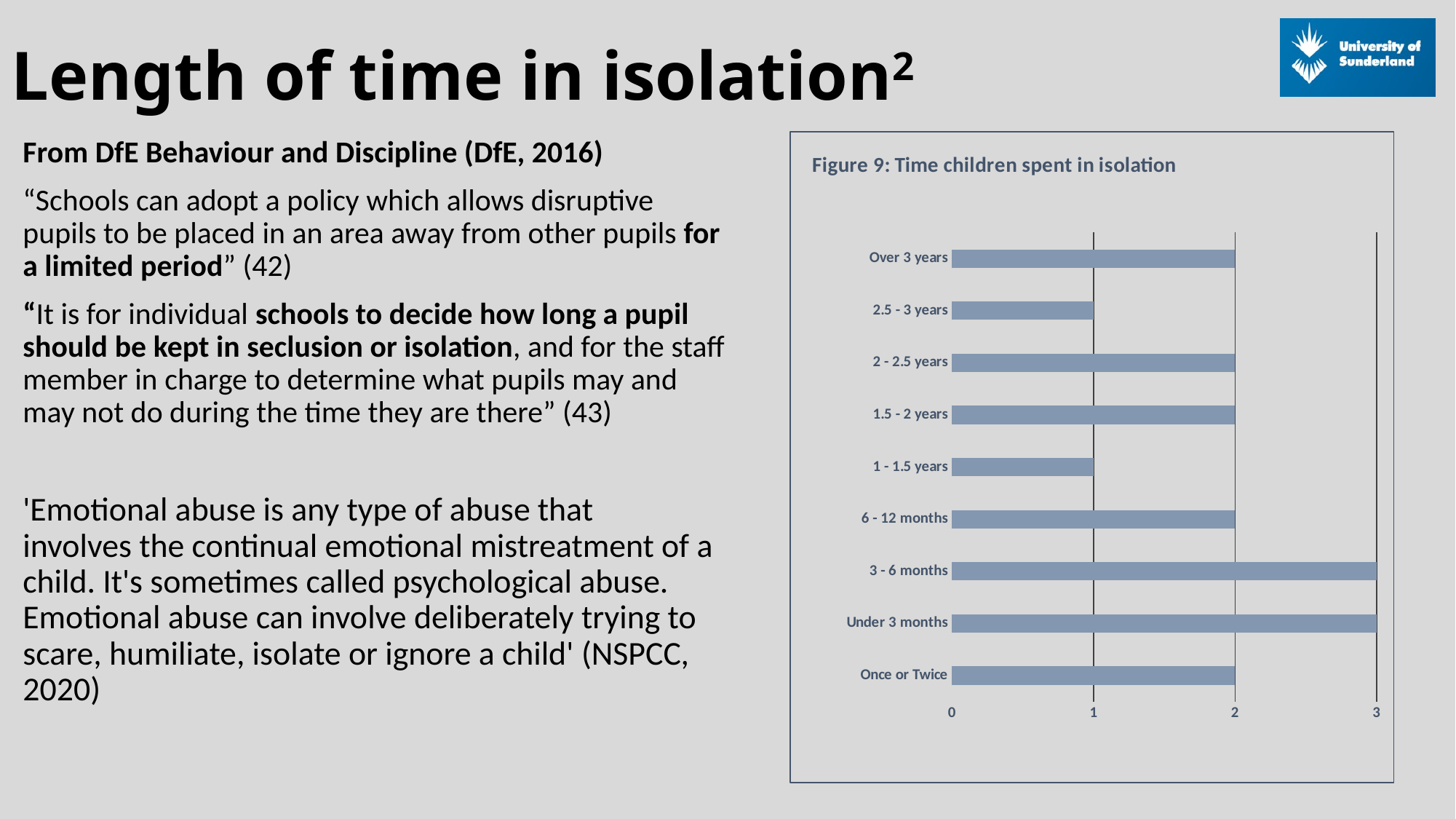
Which is larger in the chart, the value for Under 3 months or the value for Over 3 years? Under 3 months What is the value for Once or Twice in the chart? 2 How many categories are plotted in the chart? 9 Which is larger in the chart, the value for 6 - 12 months or the value for 2.5 - 3 years? 6 - 12 months What is the value for 2.5 - 3 years in the chart? 1 What is the value for 3 - 6 months in the chart? 3 What is the value for Under 3 months in the chart? 3 What kind of chart is shown in Figure 9: Time children spent in isolation? bar chart What is the title of the chart on the slide? Figure 9: Time children spent in isolation What is the value for 1 - 1.5 years in the chart? 1 What is the difference between the value for 3 - 6 months and the value for 1 - 1.5 years in the chart? 2 What is the difference between the value for Over 3 years and the value for 2.5 - 3 years in the chart? 1